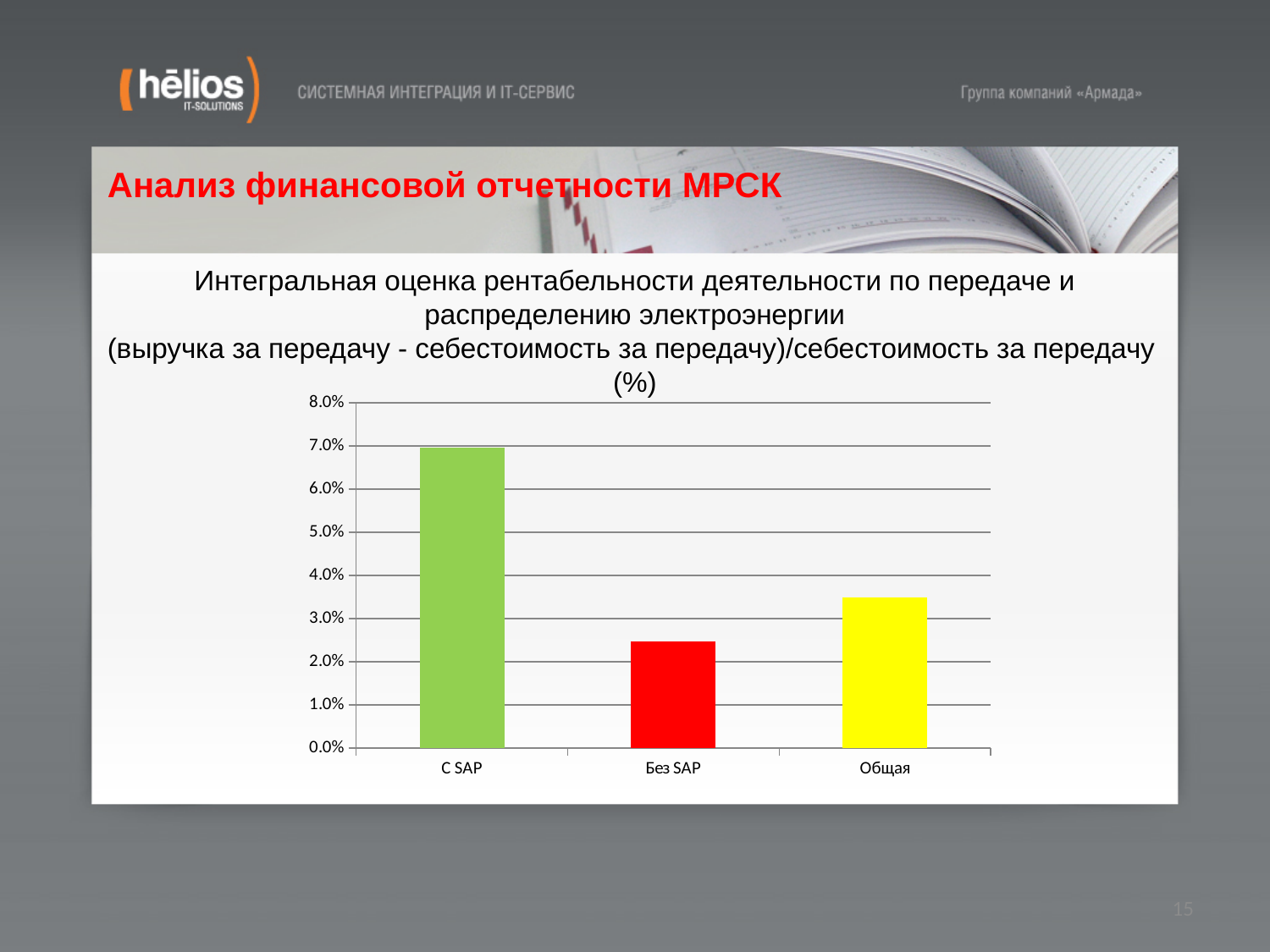
What kind of chart is shown on the slide? Bar chart What is the highest value shown on the vertical axis? 8.0% Which is larger, the value for Без SAP or the value for Общая? Общая Is the value for Общая greater or less than 4.0%? less Is the value for Общая greater or less than 3.0%? greater What colour is the bar for Без SAP? Red Which category has the lowest value? Без SAP Is the value for Без SAP greater or less than 3.0%? less How many categories are plotted on the chart? 3 Which category has the highest value? С SAP Which is larger, the value for С SAP or the value for Общая? С SAP